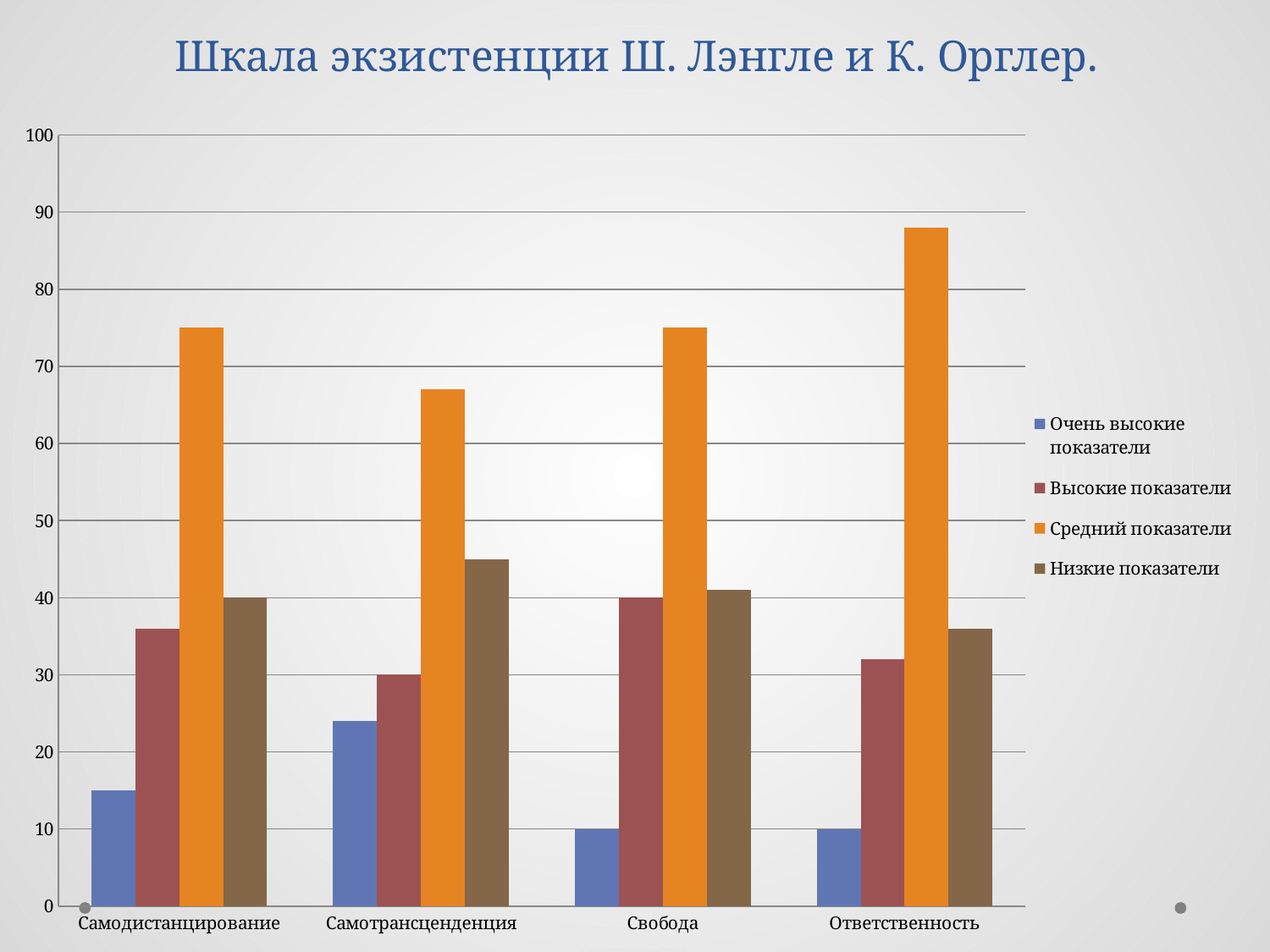
Is the value for 'Низкие показатели' in the category 'Самотрансценденция' greater or less than 50? less Which category has the highest value for the series 'Очень высокие показатели'? Самотрансценденция How many series does the legend list? 4 How many categories are shown along the x axis? 4 Which is larger in the category 'Самотрансценденция': 'Высокие показатели' or 'Низкие показатели'? Низкие показатели Which is larger in the category 'Ответственность': 'Высокие показатели' or 'Очень высокие показатели'? Высокие показатели Which category has the highest value for the series 'Средний показатели'? Ответственность What is the title of the chart? Шкала экзистенции Ш. Лэнгле и К. Орглер. Which category has the lowest value for the series 'Средний показатели'? Самотрансценденция What kind of chart is shown on the slide? bar chart Is the value for 'Очень высокие показатели' in the category 'Самодистанцирование' greater or less than 20? less Is the value for 'Средний показатели' in the category 'Ответственность' greater or less than 80? greater